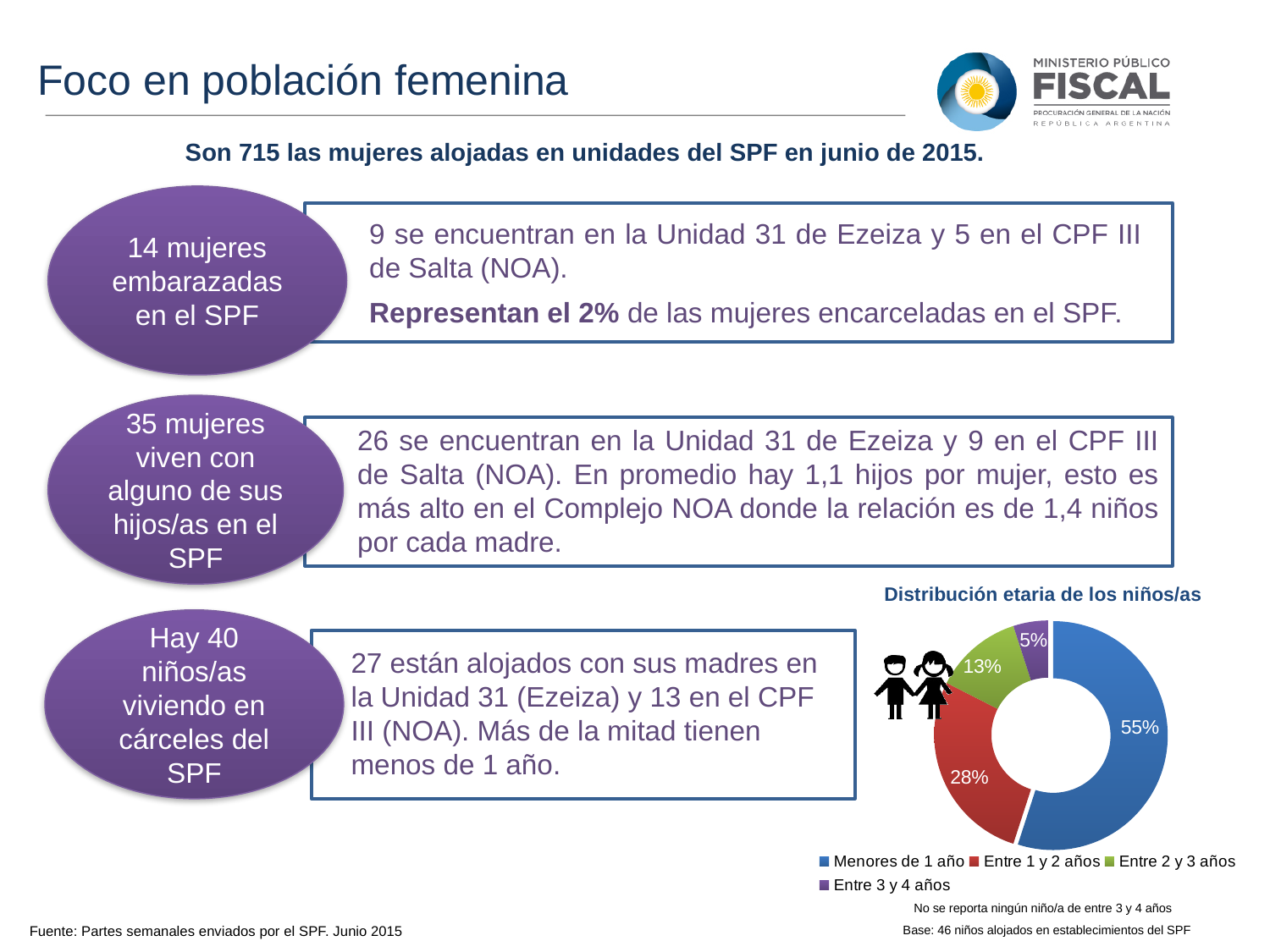
What kind of chart is shown under the title 'Distribución etaria de los niños/as'? Doughnut (pie) chart In the 'Distribución etaria de los niños/as' chart, which is larger: 'Entre 1 y 2 años' or 'Entre 2 y 3 años'? Entre 1 y 2 años In the 'Distribución etaria de los niños/as' chart, what is the difference in percentage points between 'Menores de 1 año' and 'Entre 1 y 2 años'? 27 percentage points In the 'Distribución etaria de los niños/as' chart, what percentage corresponds to 'Entre 2 y 3 años'? 13% In the 'Distribución etaria de los niños/as' chart, what percentage corresponds to 'Menores de 1 año'? 55% How many entries does the legend of the 'Distribución etaria de los niños/as' chart list? 4 In the 'Distribución etaria de los niños/as' chart, what percentage corresponds to 'Entre 3 y 4 años'? 5% Which age group has the largest slice in the 'Distribución etaria de los niños/as' chart? Menores de 1 año In the 'Distribución etaria de los niños/as' chart, what percentage corresponds to 'Entre 1 y 2 años'? 28% What colour represents 'Menores de 1 año' in the 'Distribución etaria de los niños/as' chart? Blue How many age groups are shown in the 'Distribución etaria de los niños/as' chart? 4 Which age group has the smallest slice in the 'Distribución etaria de los niños/as' chart? Entre 3 y 4 años